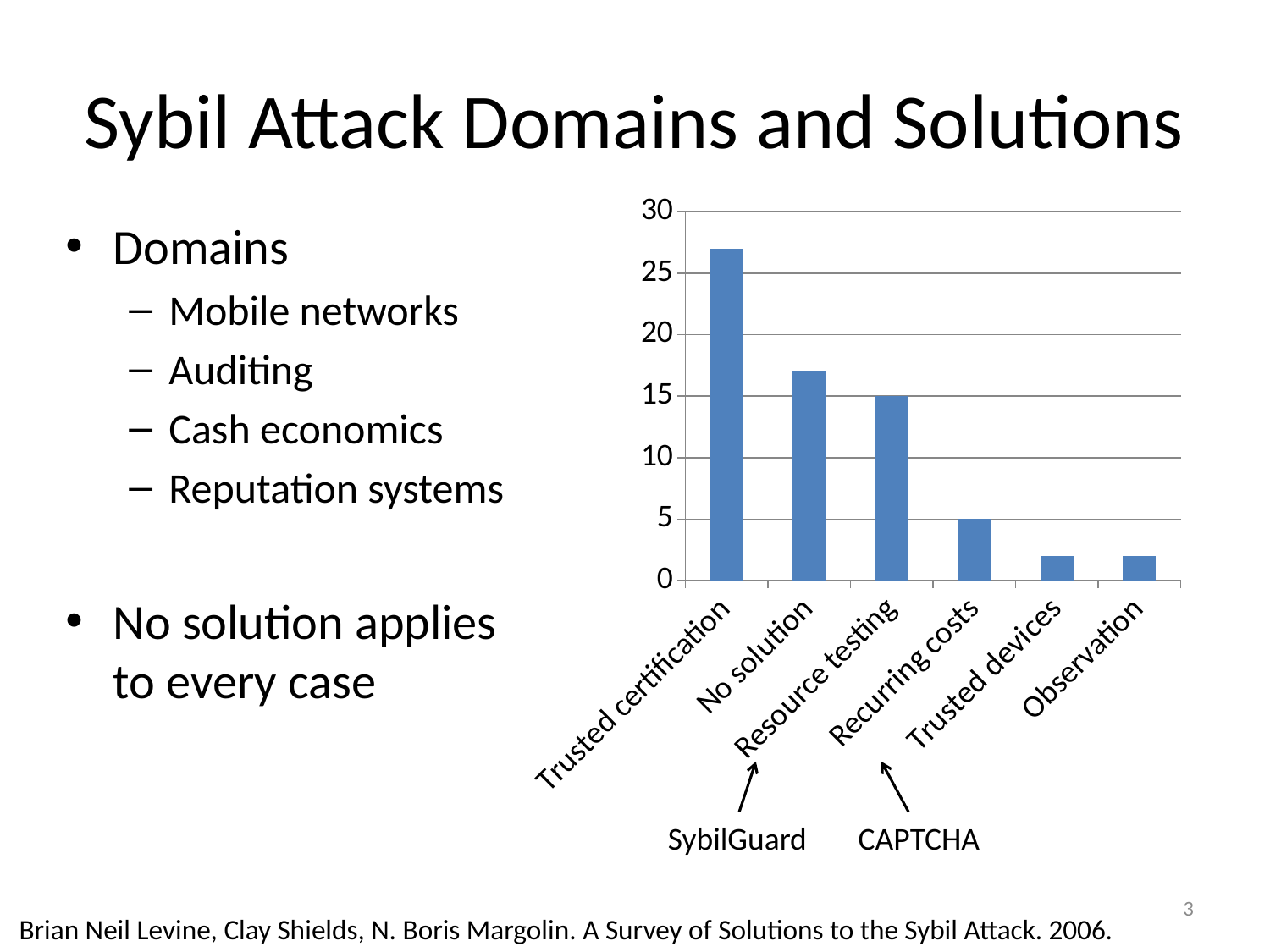
Which is larger, the value for No solution or the value for Recurring costs? No solution Is the value for Trusted certification greater or less than 25? greater Is the value for No solution greater or less than 20? less Do the bar values generally rise or fall from left to right along the x axis? fall What is the value for Recurring costs? 5 Is the value for Trusted devices greater or less than 5? less Which category has the highest bar in the chart? Trusted certification What is the value for Resource testing? 15 How many categories are shown on the x axis of the chart? 6 What kind of chart is shown on the slide? bar chart Which category on the x axis is annotated with the label CAPTCHA? Recurring costs